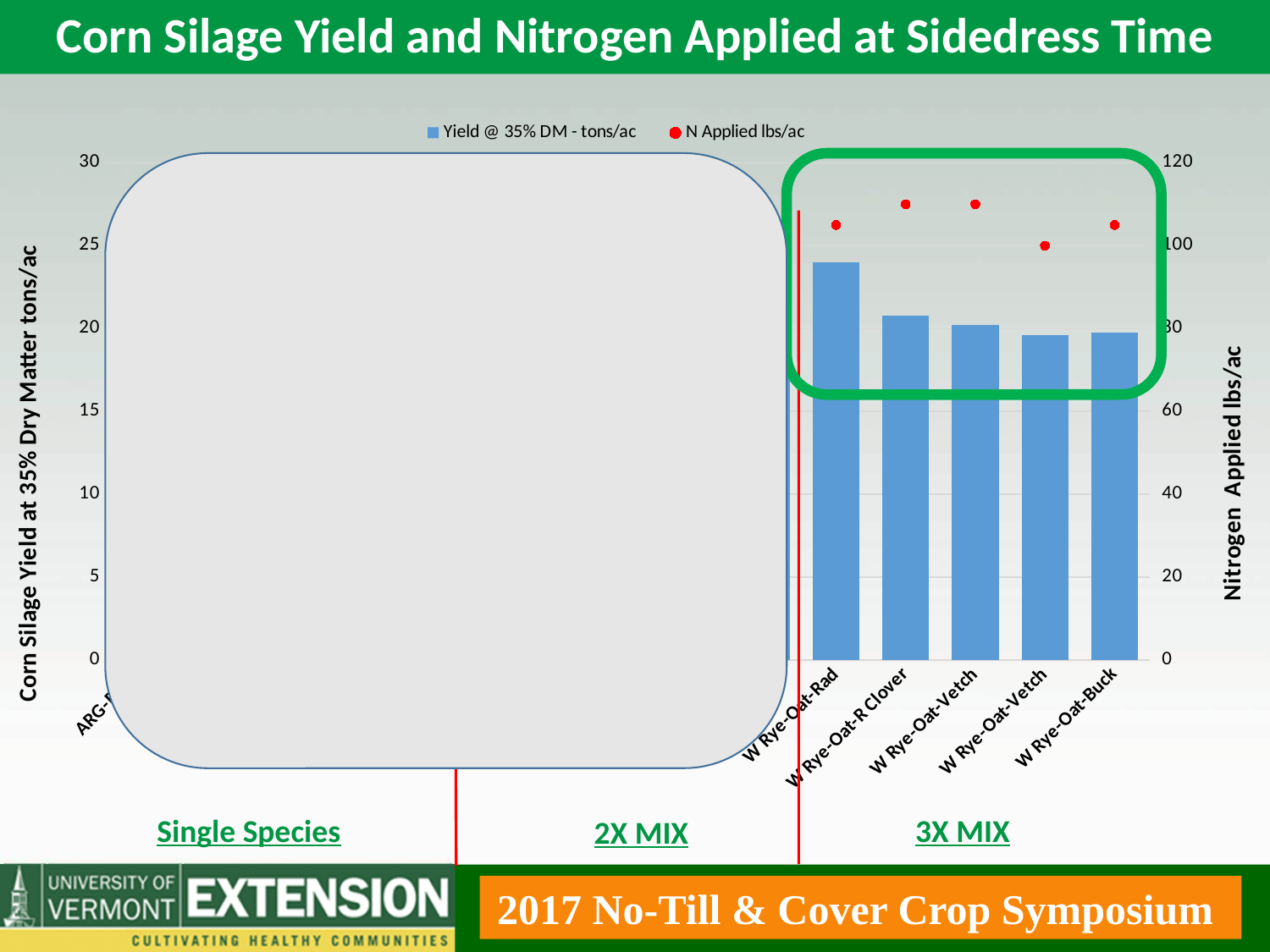
Which has the higher yield, W Rye-Oat-Rad or W Rye-Oat-R Clover? W Rye-Oat-Rad Which has the higher yield, W Rye-Oat-Rad or W Rye-Oat-Buck? W Rye-Oat-Rad What kind of chart is used to plot the Yield @ 35% DM - tons/ac series? bar chart How many series does the legend list? 2 What is the label of the right-hand vertical axis? Nitrogen Applied lbs/ac Is the yield for W Rye-Oat-Rad greater or less than 20 tons/ac? greater Among the visible bars in the 3X MIX group, which category has the highest yield? W Rye-Oat-Rad Is the yield for W Rye-Oat-Buck greater or less than 25 tons/ac? less Is the yield for W Rye-Oat-R Clover greater or less than 25 tons/ac? less What is the title of the chart? Corn Silage Yield and Nitrogen Applied at Sidedress Time